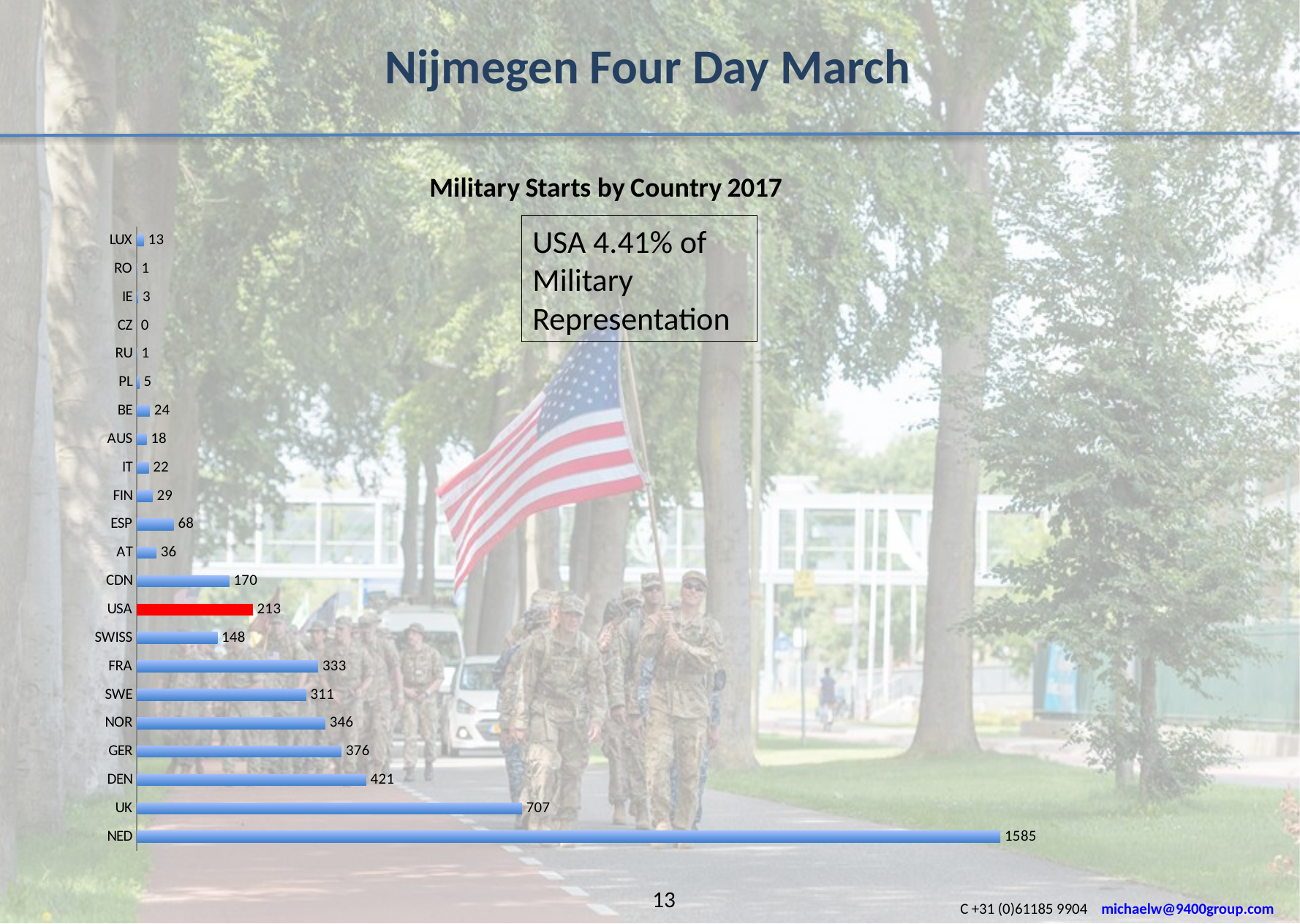
What is the value for USA in the Military Starts by Country 2017 chart? 213 Which country has the highest number of military starts in the chart? NED What kind of chart is shown on the slide? Bar chart Which has a larger value in the chart, CDN or SWISS? CDN What is the value for NED in the Military Starts by Country 2017 chart? 1585 What is the value for ESP in the Military Starts by Country 2017 chart? 68 Which country's bar is coloured red in the chart? USA What is the title of the chart on the slide? Military Starts by Country 2017 Which has a larger value in the chart, FRA or SWE? FRA What is the difference between the values for UK and DEN in the chart? 286 Which country has the lowest number of military starts in the chart? CZ How many countries are shown in the Military Starts by Country 2017 chart? 22